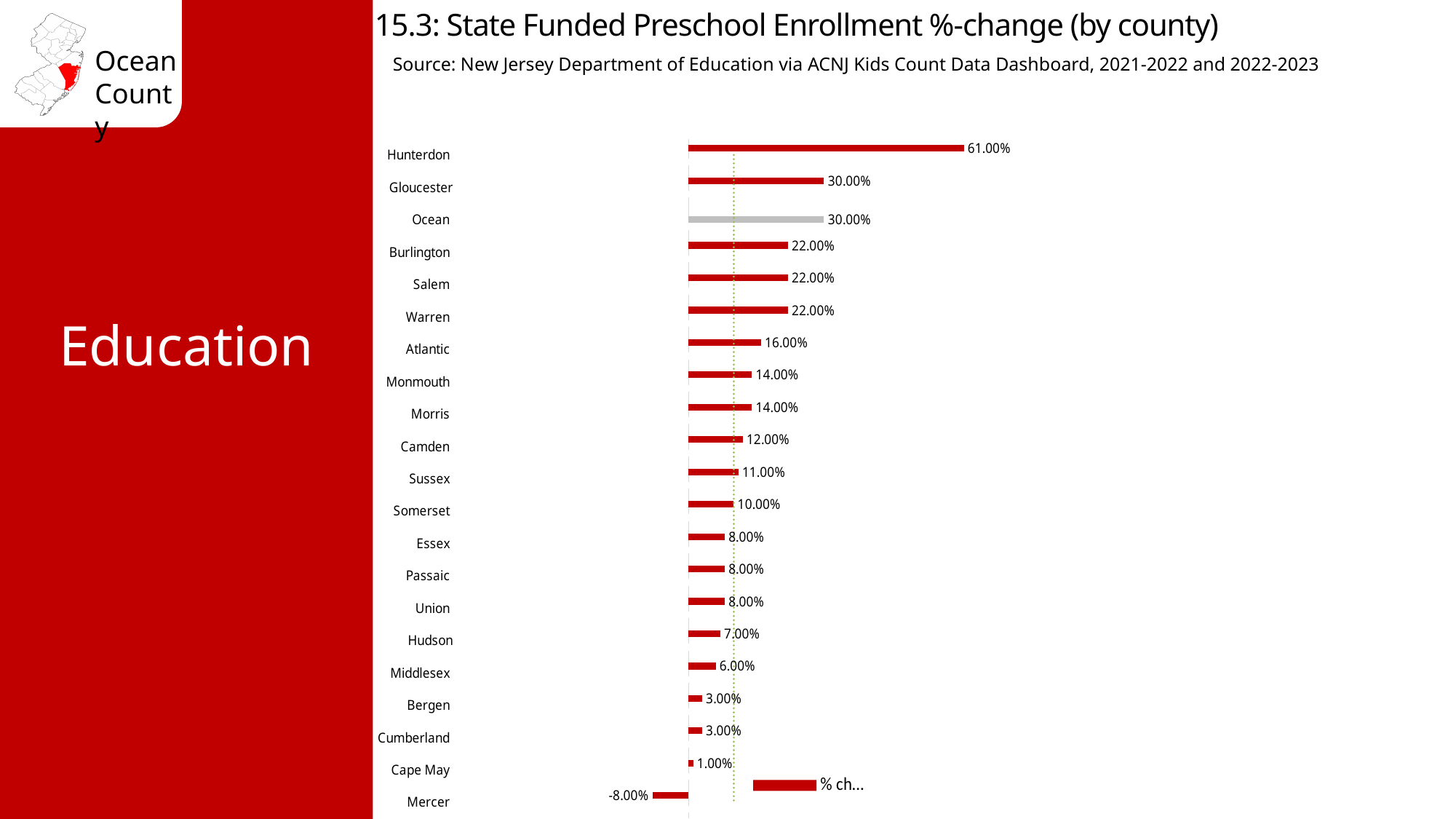
What is the difference between the values for Ocean and Mercer? 38.00% How many counties are shown in the chart? 21 What is the state funded preschool enrollment %-change for Ocean County? 30.00% What is the value shown for Hunterdon? 61.00% Which county has the highest %-change in state funded preschool enrollment? Hunterdon What is the difference between the values for Hunterdon and Gloucester? 31.00% Which has a larger %-change, Atlantic or Camden? Atlantic What type of chart is shown on the slide? Bar chart Which county has the lowest %-change in state funded preschool enrollment? Mercer What is the value shown for Mercer? -8.00% Which county's bar is coloured grey instead of red? Ocean What is the value shown for Cape May? 1.00%